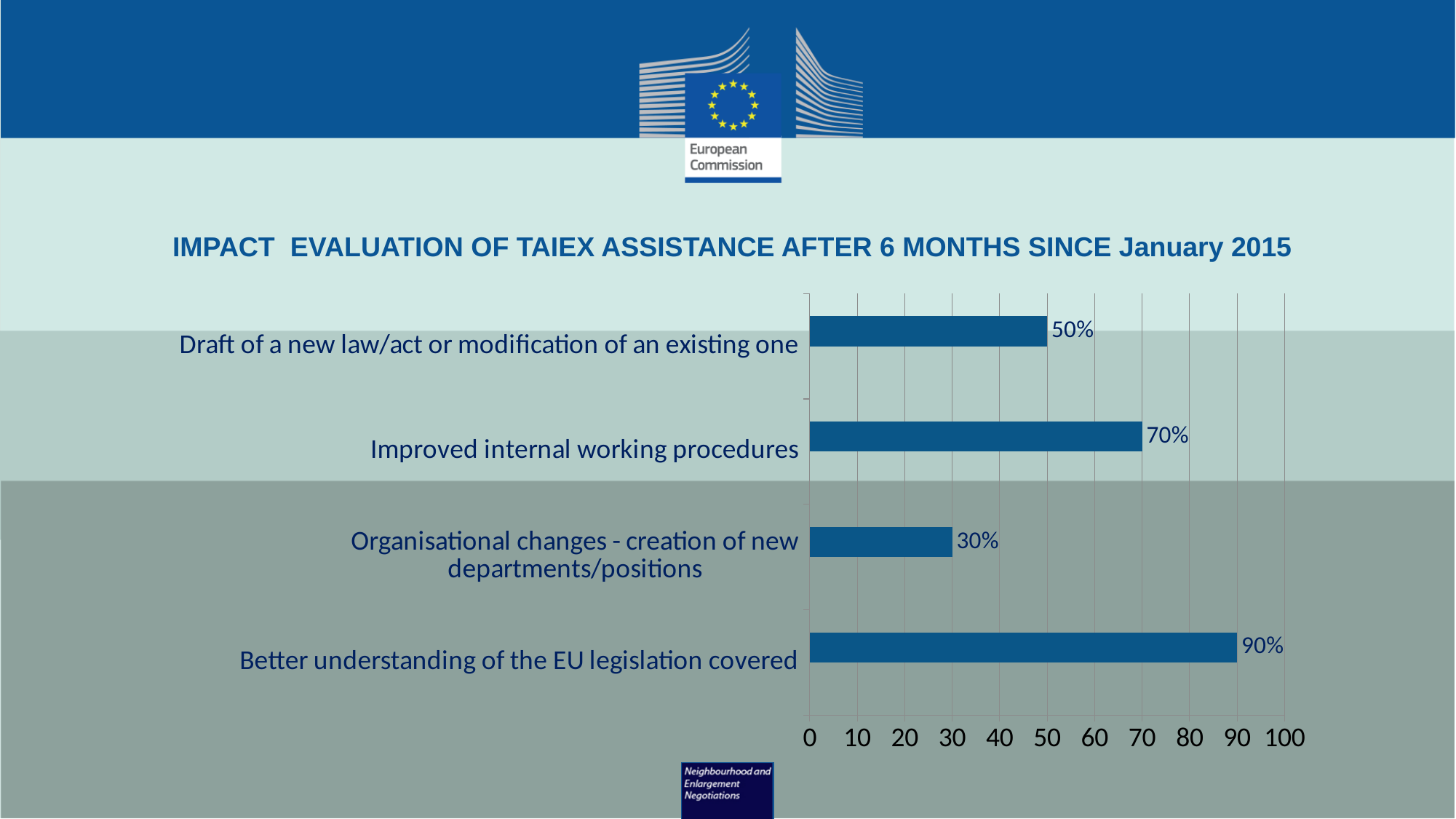
What is the difference between the values for 'Better understanding of the EU legislation covered' and 'Organisational changes - creation of new departments/positions'? 60% Which category has the lowest value? Organisational changes - creation of new departments/positions What is the value for 'Organisational changes - creation of new departments/positions'? 30% What is the title of the chart? IMPACT EVALUATION OF TAIEX ASSISTANCE AFTER 6 MONTHS SINCE January 2015 Which category has the highest value? Better understanding of the EU legislation covered What kind of chart is shown on the slide? Bar chart How many categories are shown in the chart? 4 What is the value for 'Better understanding of the EU legislation covered'? 90% What is the value for 'Improved internal working procedures'? 70% Which is larger: the value for 'Improved internal working procedures' or the value for 'Draft of a new law/act or modification of an existing one'? Improved internal working procedures What is the value for 'Draft of a new law/act or modification of an existing one'? 50% What is the difference between the values for 'Improved internal working procedures' and 'Draft of a new law/act or modification of an existing one'? 20%